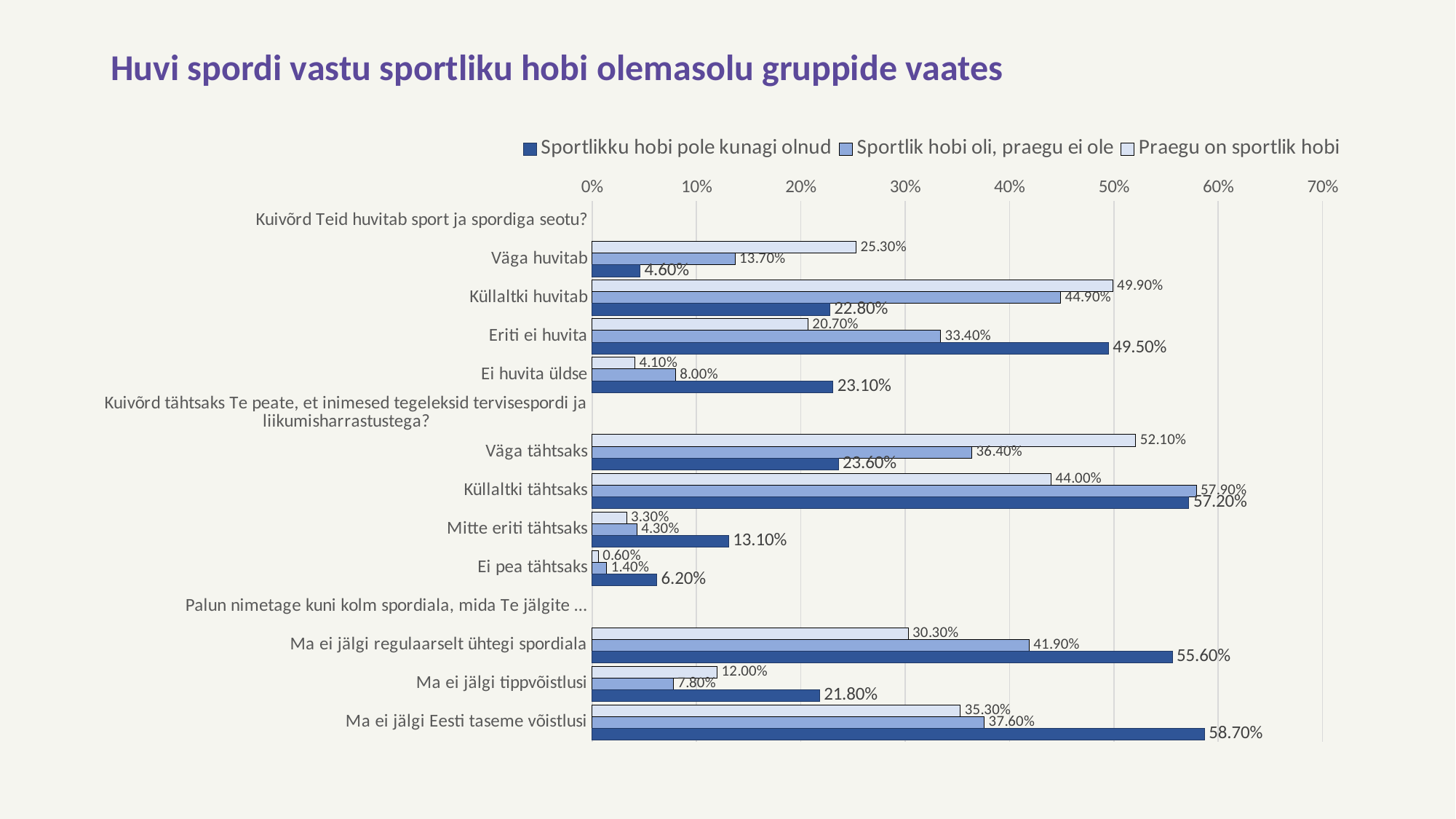
What is the difference between "Sportlikku hobi pole kunagi olnud" and "Praegu on sportlik hobi" in the "Ma ei jälgi regulaarselt ühtegi spordiala" category? 25.30% What is the value for "Sportlik hobi oli, praegu ei ole" in the "Küllaltki tähtsaks" category? 57.90% Which series has the highest value in the "Väga tähtsaks" category? Praegu on sportlik hobi Which series has the lowest value in the "Ei pea tähtsaks" category? Praegu on sportlik hobi What is the value for "Praegu on sportlik hobi" in the "Väga huvitab" category? 25.30% What kind of chart is shown on the slide? bar chart In the "Ma ei jälgi tippvõistlusi" category, which is larger: "Praegu on sportlik hobi" or "Sportlik hobi oli, praegu ei ole"? Praegu on sportlik hobi How many series does the legend list? 3 What is the title of the chart? Huvi spordi vastu sportliku hobi olemasolu gruppide vaates What is the value for "Sportlikku hobi pole kunagi olnud" in the "Eriti ei huvita" category? 49.50% What is the value for "Sportlikku hobi pole kunagi olnud" in the "Ma ei jälgi Eesti taseme võistlusi" category? 58.70% Is the value for "Sportlikku hobi pole kunagi olnud" in the "Küllaltki huvitab" category greater or less than 30%? less